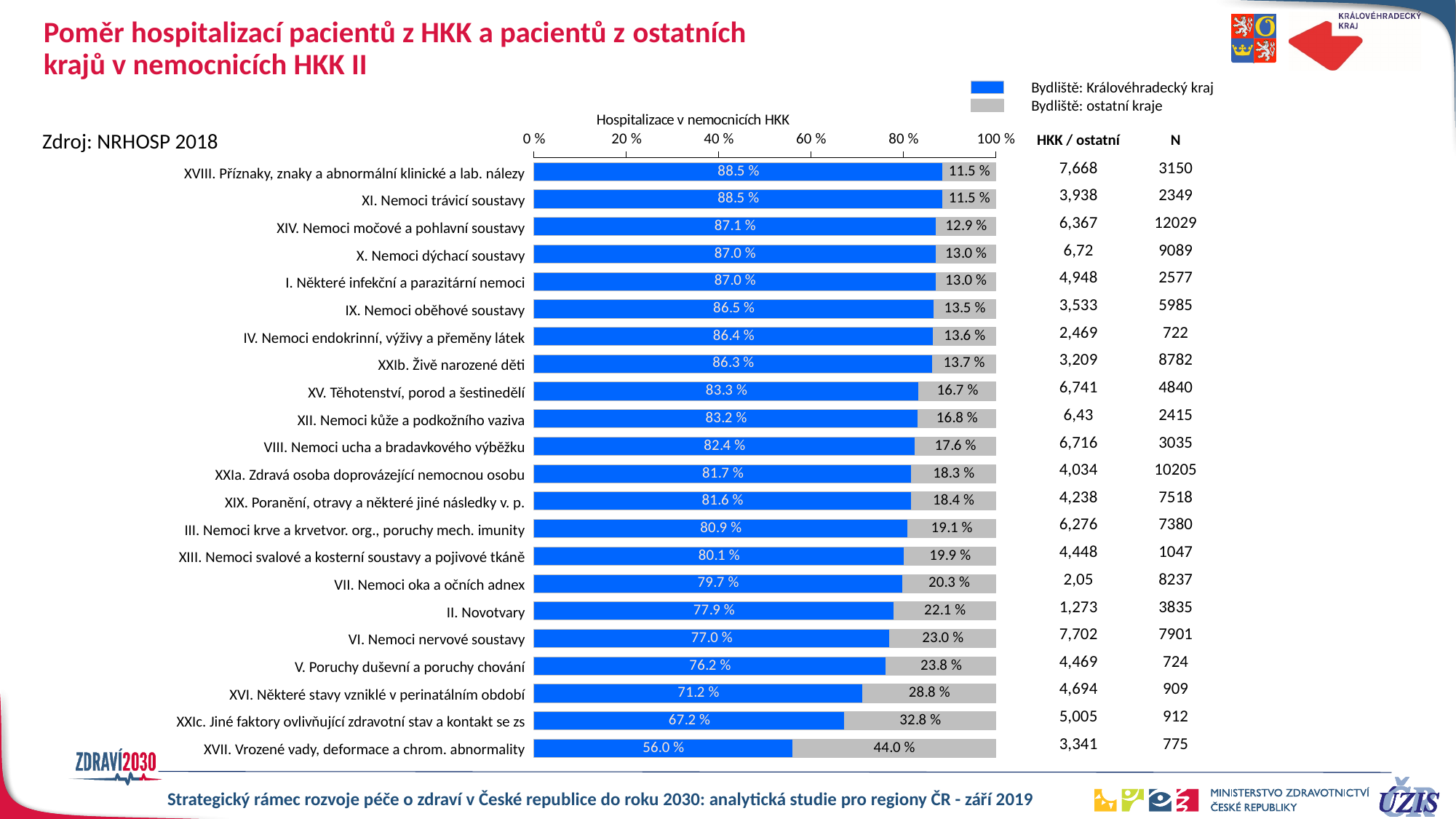
What is the share of patients from other regions (Bydliště: ostatní kraje) for 'II. Novotvary'? 22.1 % For 'XVI. Některé stavy vzniklé v perinatálním období', what is the difference in percentage points between the Královéhradecký kraj share and the ostatní kraje share? 42.4 percentage points What are the two legend entries of the chart? Bydliště: Královéhradecký kraj; Bydliště: ostatní kraje How many diagnosis categories are shown in the chart? 22 Which category has the lowest share of patients with residence in Královéhradecký kraj? XVII. Vrozené vady, deformace a chrom. abnormality What percentage of hospitalizations for 'XVII. Vrozené vady, deformace a chrom. abnormality' are patients with residence in Královéhradecký kraj? 56.0 % Which has a larger share of patients from Královéhradecký kraj: 'XV. Těhotenství, porod a šestinedělí' or 'XIX. Poranění, otravy a některé jiné následky v. p.'? XV. Těhotenství, porod a šestinedělí What type of chart is shown on the slide? Stacked bar chart Is the Královéhradecký kraj share for 'XXIc. Jiné faktory ovlivňující zdravotní stav a kontakt se zs' greater or less than 60 %? greater Which category has the highest share of patients from other regions (ostatní kraje)? XVII. Vrozené vady, deformace a chrom. abnormality How many series does the legend list? 2 What is the total of the stacked bar for 'IX. Nemoci oběhové soustavy'? 100 %